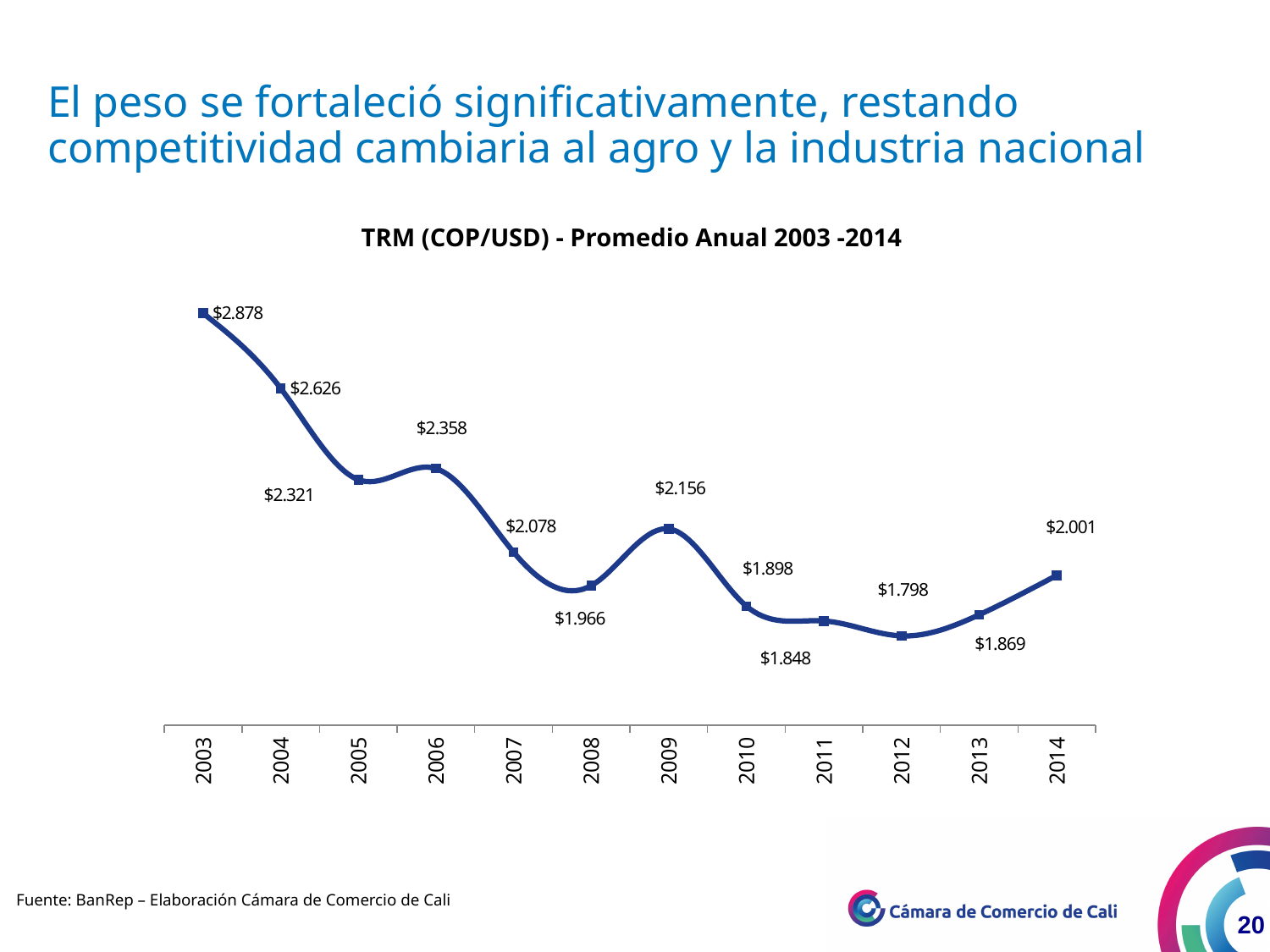
Does the TRM value rise or fall from 2003 to 2012? Fall What is the title of the chart? TRM (COP/USD) - Promedio Anual 2003 -2014 What is the difference between the TRM values for 2003 and 2004? $252 Which year has the highest TRM value? 2003 Which year has the lowest TRM value? 2012 Which year has a larger TRM value, 2006 or 2005? 2006 What is the TRM value for 2012? $1.798 What is the TRM value for 2009? $2.156 What kind of chart is shown on the slide? Line chart How many years are plotted on the chart? 12 What is the TRM value for 2014? $2.001 What is the TRM value for 2003? $2.878